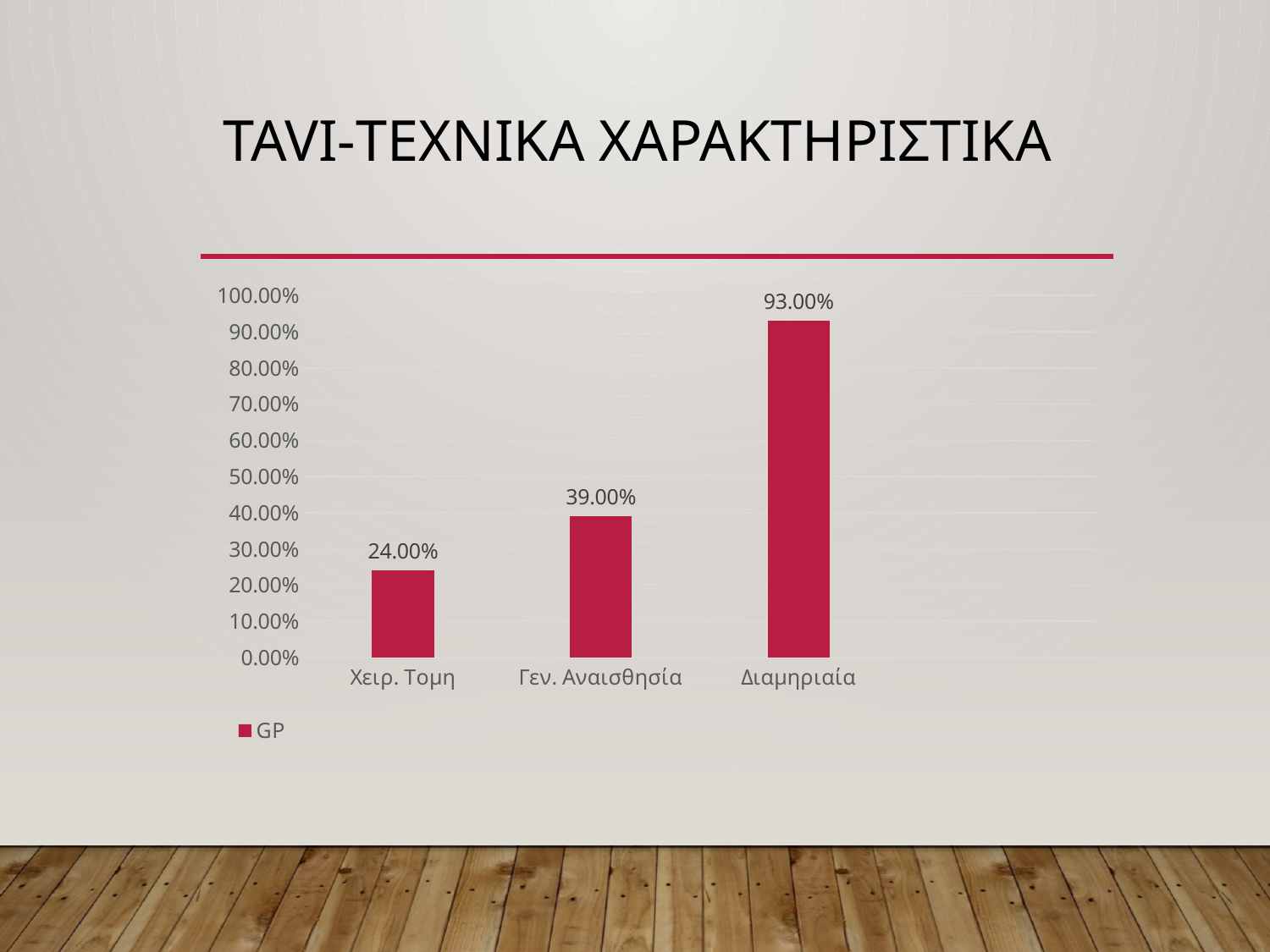
Is the value for Διαμηριαία greater or less than 90.00%? greater What is the value for Χειρ. Τομη? 24.00% How many series does the legend list? 1 What is the difference between the values for Διαμηριαία and Γεν. Αναισθησία? 54.00% What is the value for Διαμηριαία? 93.00% Which category has the highest value? Διαμηριαία What is the difference between the values for Γεν. Αναισθησία and Χειρ. Τομη? 15.00% What kind of chart is shown on the slide? bar chart How many categories are shown on the x axis? 3 Which category has the lowest value? Χειρ. Τομη What is the value for Γεν. Αναισθησία? 39.00% Which is larger, the value for Χειρ. Τομη or the value for Γεν. Αναισθησία? Γεν. Αναισθησία